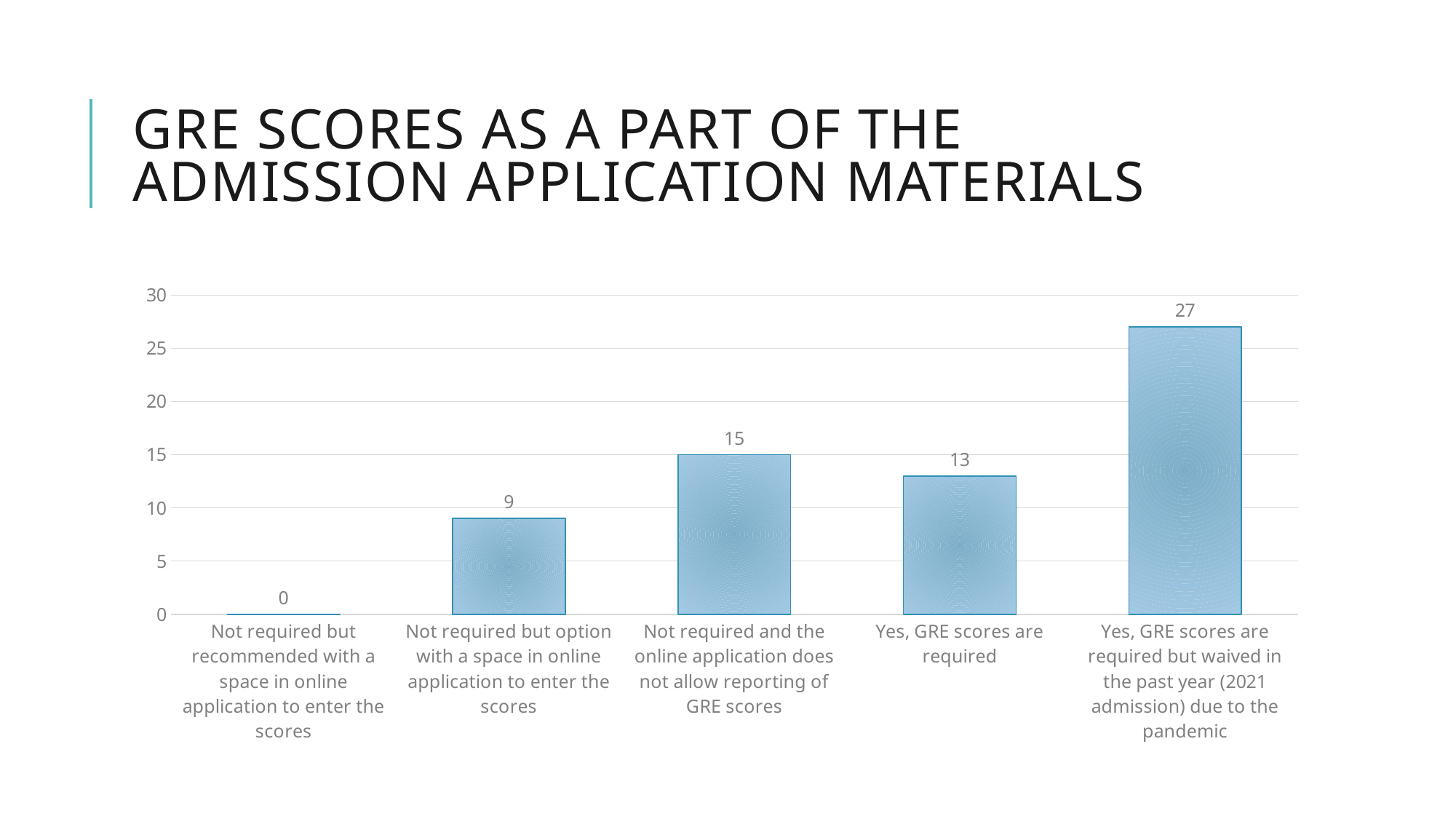
Which category has the lowest value? Not required but recommended with a space in online application to enter the scores How many categories are shown on the chart? 5 What is the value for "Not required but recommended with a space in online application to enter the scores"? 0 What is the title of the slide? GRE SCORES AS A PART OF THE ADMISSION APPLICATION MATERIALS What is the value for "Yes, GRE scores are required"? 13 Is the value for "Yes, GRE scores are required but waived in the past year (2021 admission) due to the pandemic" greater or less than 25? greater What is the difference between the value for "Yes, GRE scores are required but waived in the past year (2021 admission) due to the pandemic" and the value for "Yes, GRE scores are required"? 14 What is the value for "Not required and the online application does not allow reporting of GRE scores"? 15 What kind of chart is shown on the slide? bar chart Which category has the highest value? Yes, GRE scores are required but waived in the past year (2021 admission) due to the pandemic Which is larger: the value for "Not required and the online application does not allow reporting of GRE scores" or the value for "Yes, GRE scores are required"? Not required and the online application does not allow reporting of GRE scores What is the value for "Not required but option with a space in online application to enter the scores"? 9